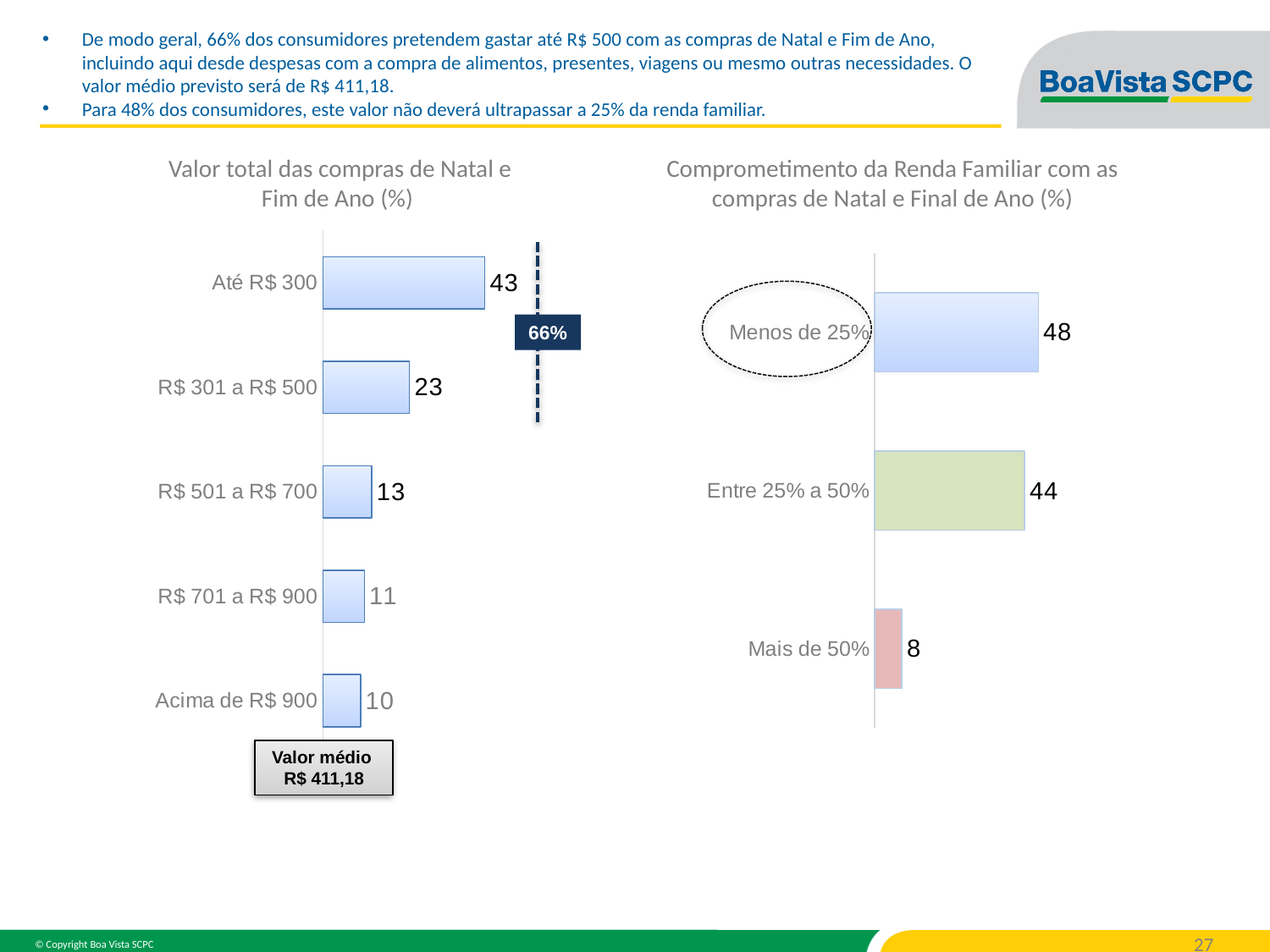
In the chart 'Comprometimento da Renda Familiar com as compras de Natal e Final de Ano (%)', what is the value for 'Entre 25% a 50%'? 44 In the chart 'Valor total das compras de Natal e Fim de Ano (%)', do the values rise or fall from the top category to the bottom category? fall In the chart 'Valor total das compras de Natal e Fim de Ano (%)', how many categories are shown? 5 In the chart 'Comprometimento da Renda Familiar com as compras de Natal e Final de Ano (%)', what is the difference between 'Entre 25% a 50%' and 'Mais de 50%'? 36 In the chart 'Valor total das compras de Natal e Fim de Ano (%)', what is the value for 'R$ 501 a R$ 700'? 13 In the chart 'Valor total das compras de Natal e Fim de Ano (%)', what is the value for 'Até R$ 300'? 43 In the chart 'Comprometimento da Renda Familiar com as compras de Natal e Final de Ano (%)', which category has the highest value? Menos de 25% In the chart 'Comprometimento da Renda Familiar com as compras de Natal e Final de Ano (%)', which is larger, 'Menos de 25%' or 'Mais de 50%'? Menos de 25% What kind of chart is the chart on the right of the slide? bar chart In the chart 'Valor total das compras de Natal e Fim de Ano (%)', which category has the lowest value? Acima de R$ 900 In the chart 'Valor total das compras de Natal e Fim de Ano (%)', what average value is shown in the box below the bars? R$ 411,18 In the chart 'Valor total das compras de Natal e Fim de Ano (%)', what is the difference between 'Até R$ 300' and 'R$ 301 a R$ 500'? 20